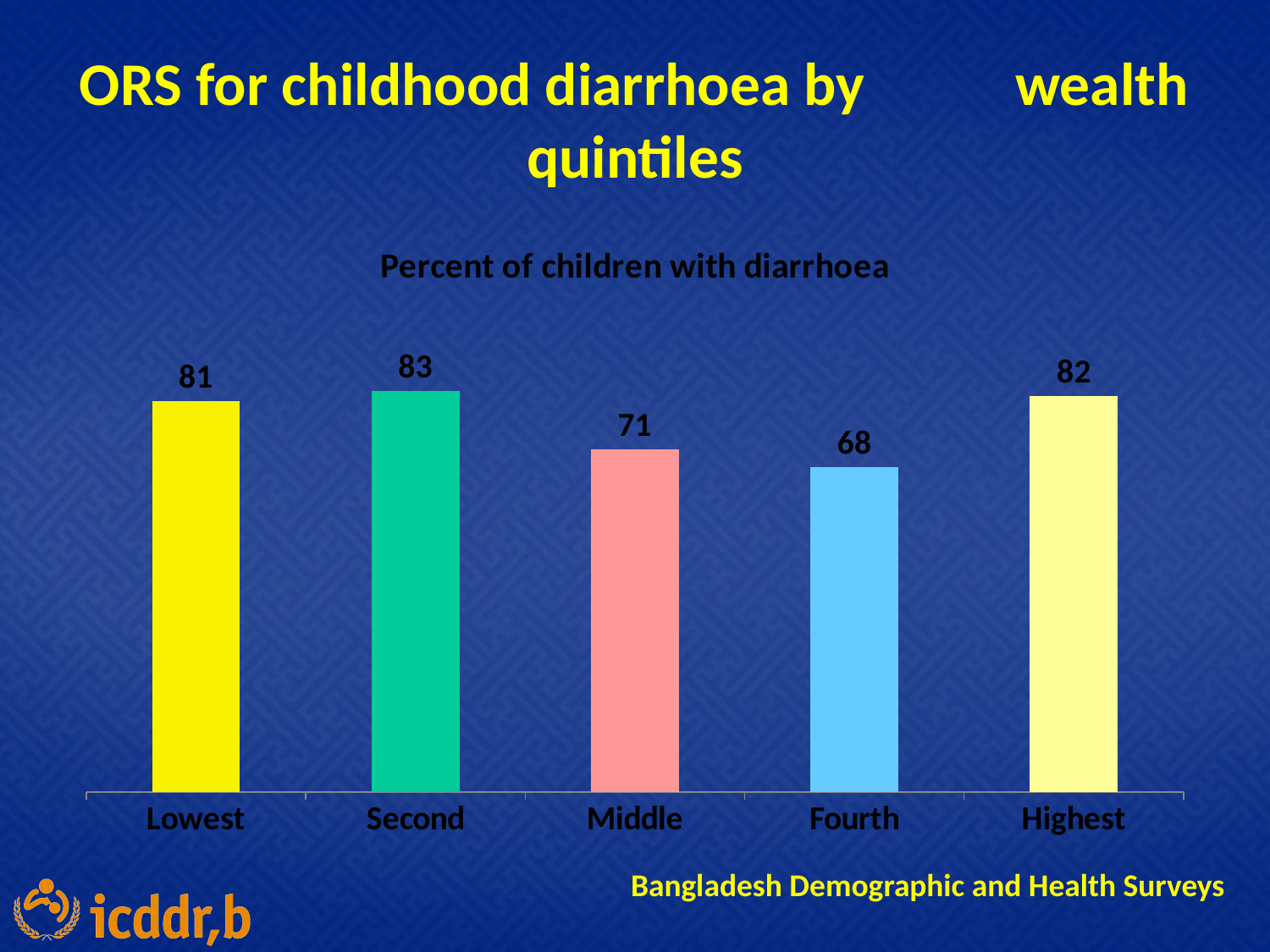
Which wealth quintile has the lowest value? Fourth What is the value for the Highest wealth quintile? 82 What is the value for the Lowest wealth quintile? 81 What is the value for the Middle wealth quintile? 71 What kind of chart is shown on the slide? Bar chart What is the difference between the values for the Highest and Middle quintiles? 11 What is the value for the Fourth wealth quintile? 68 How many wealth quintile categories are shown on the chart? 5 What is the difference between the values for the Second and Fourth quintiles? 15 What is the chart's title? Percent of children with diarrhoea Which wealth quintile has the highest value? Second Which has a larger value, the Lowest quintile or the Middle quintile? Lowest